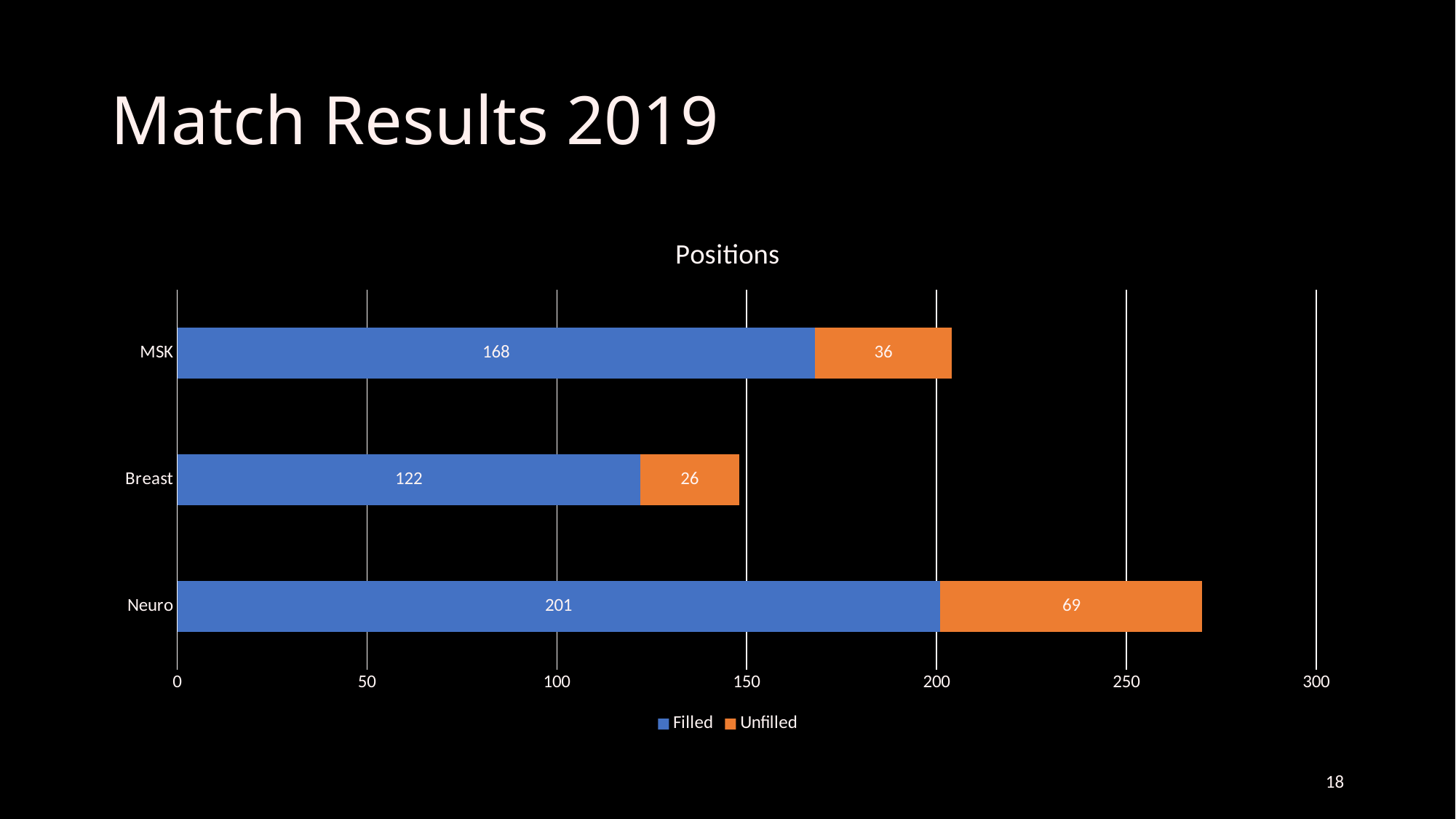
What is the total of the stacked bar for MSK? 204 What is the Filled value for MSK? 168 Which is larger, the Unfilled value for MSK or the Unfilled value for Neuro? Neuro What is the Unfilled value for Neuro? 69 What is the Unfilled value for Breast? 26 Which category has the highest Filled value? Neuro How many series does the legend list? 2 Which category has the lowest Unfilled value? Breast What is the difference between the Filled values for Neuro and Breast? 79 What kind of chart is shown on the slide? Stacked bar chart How many categories are shown on the chart? 3 What is the total of the stacked bar for Neuro? 270